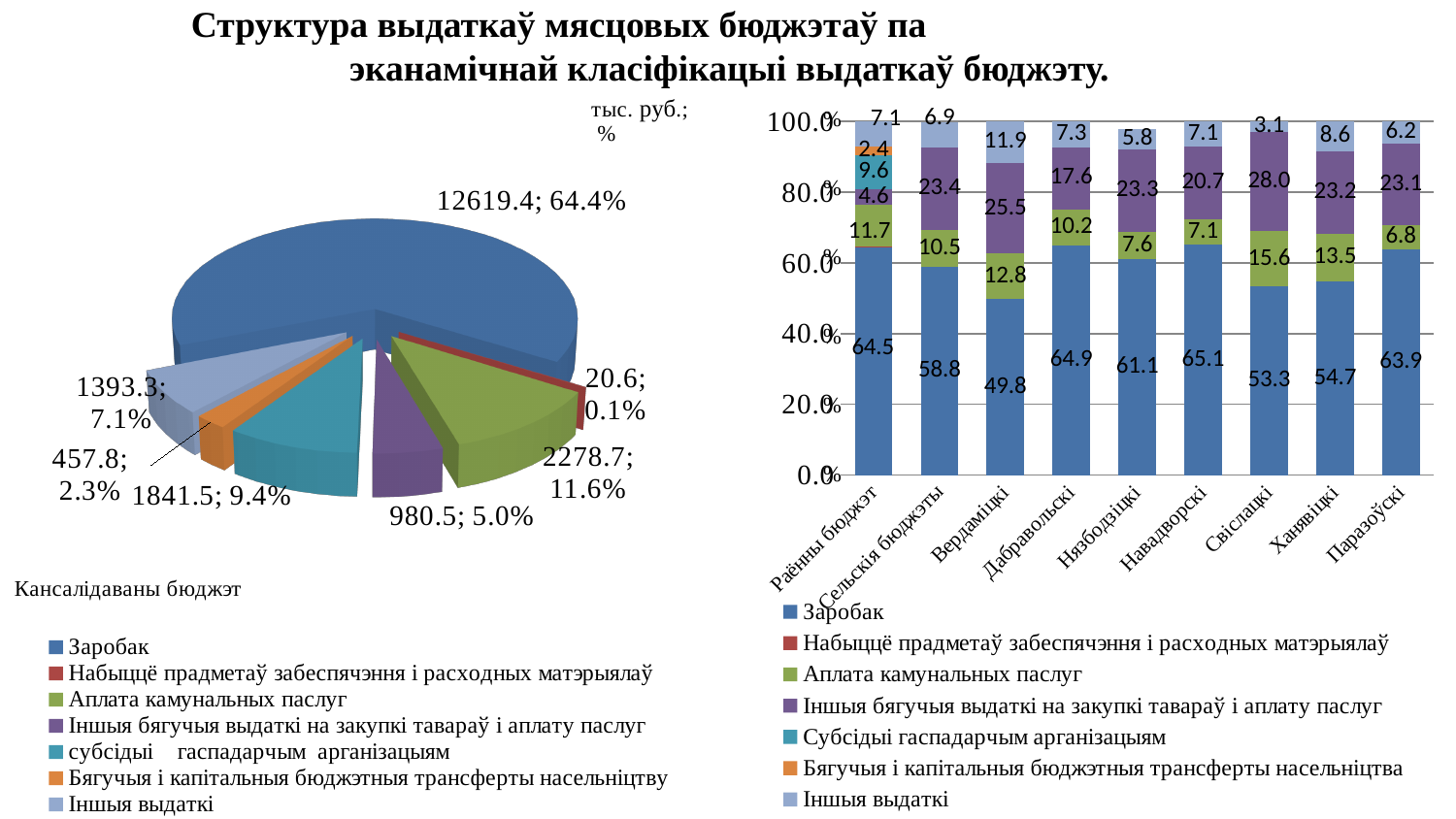
In the right bar chart, what is the difference between the Аплата камунальных паслуг values for Свіслацкі and Паразоўскі? 8.8 In the left pie chart, what share does Заробак have? 64.4% In the left pie chart, what value is printed for the Аплата камунальных паслуг slice? 2278.7; 11.6% In the right bar chart, which has the larger Заробак value: Сельскія бюджэты or Свіслацкі? Сельскія бюджэты What kind of chart is the right chart? stacked bar chart How many categories are shown on the x axis of the right bar chart? 9 In the right bar chart, which category has the lowest Заробак value? Вердаміцкі In the right bar chart, what is the Заробак value for Вердаміцкі? 49.8 In the left pie chart, which category has the smallest slice? Набыццё прадметаў забеспячэння і расходных матэрыялаў In the right bar chart, which category has the highest Іншыя выдаткі value? Вердаміцкі How many series does the legend of the right bar chart list? 7 What kind of chart is the left chart (Кансалідаваны бюджэт)? pie chart